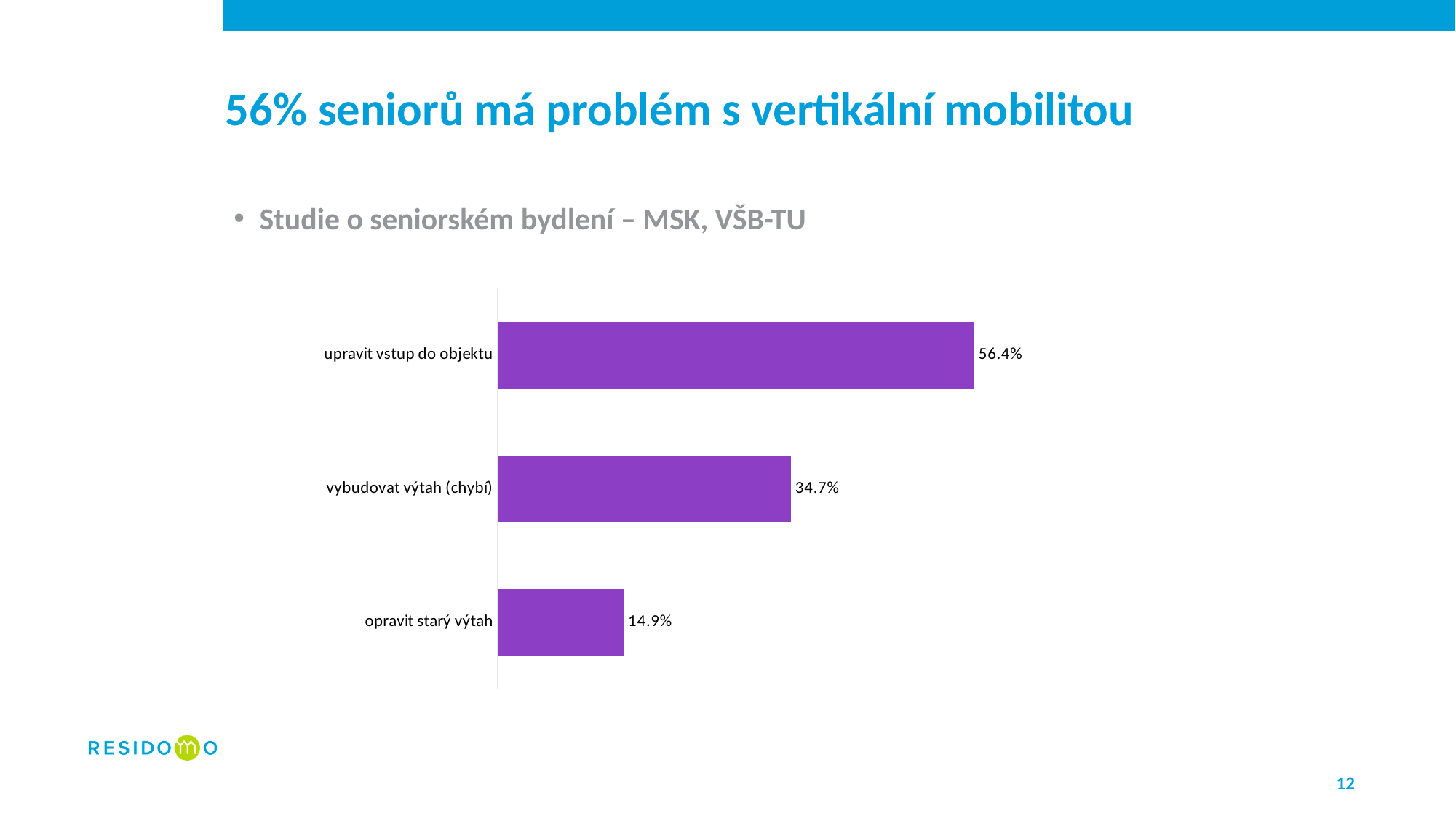
Which category has the highest value? upravit vstup do objektu What kind of chart is shown on the slide? bar chart Are the bars in the chart horizontal or vertical? horizontal What is the value for "opravit starý výtah"? 14.9% What is the value for "vybudovat výtah (chybí)"? 34.7% What is the difference between the values for "upravit vstup do objektu" and "vybudovat výtah (chybí)"? 21.7% Which is larger, the value for "vybudovat výtah (chybí)" or for "opravit starý výtah"? vybudovat výtah (chybí) What colour are the bars in the chart? purple What is the difference between the values for "vybudovat výtah (chybí)" and "opravit starý výtah"? 19.8% What is the value for "upravit vstup do objektu"? 56.4% Which category has the lowest value? opravit starý výtah How many categories are shown in the chart? 3